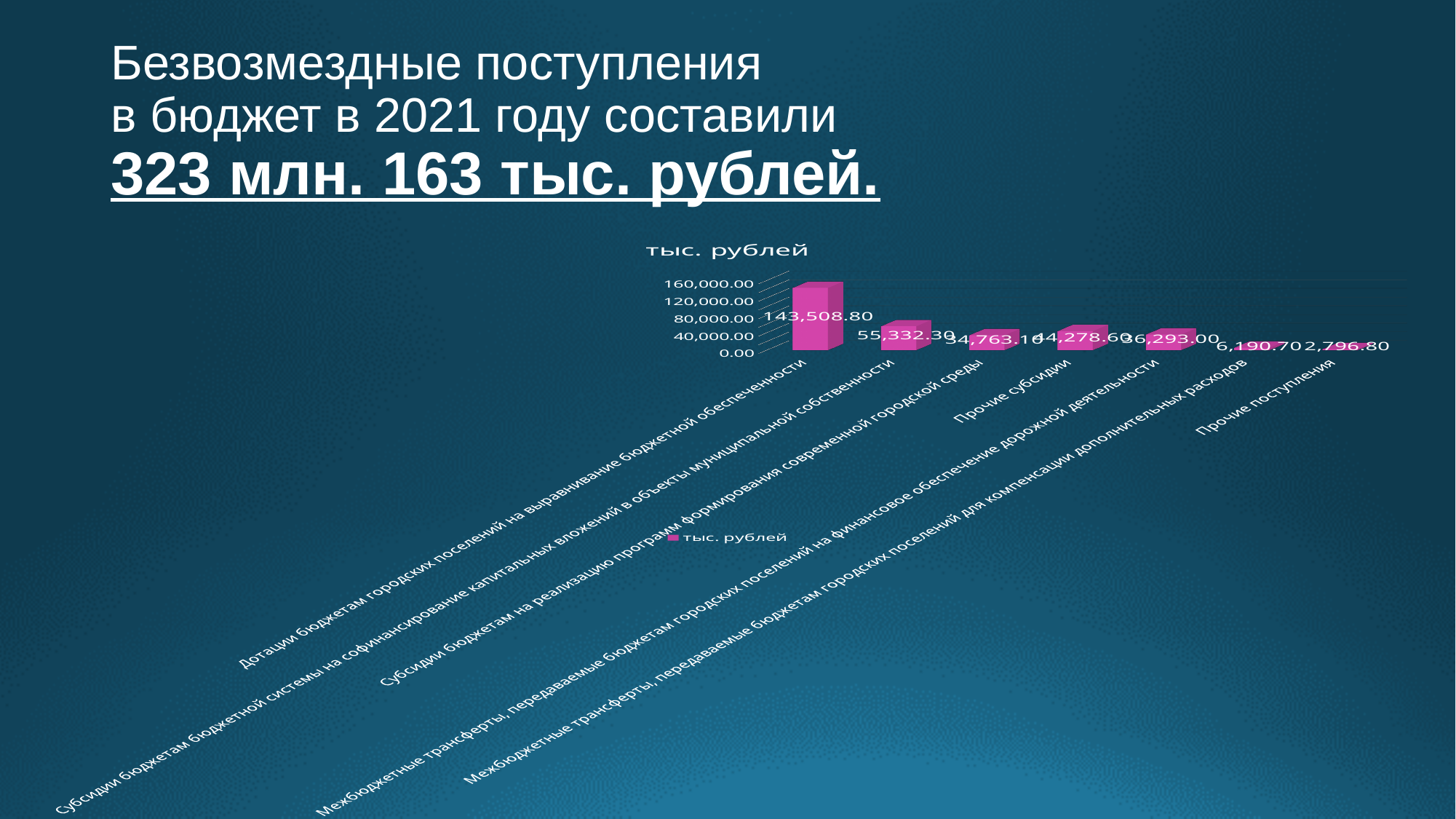
Which category has the highest value in the chart? Дотации бюджетам городских поселений на выравнивание бюджетной обеспеченности Which is larger: the value for Прочие субсидии or the value for Межбюджетные трансферты, передаваемые бюджетам городских поселений на финансовое обеспечение дорожной деятельности? Прочие субсидии How many series does the chart legend list? 1 What is the value for Прочие субсидии? 44,278.60 What is the value for Прочие поступления? 2,796.80 What is the difference between the value for Дотации бюджетам городских поселений на выравнивание бюджетной обеспеченности and the value for Субсидии бюджетам бюджетной системы на софинансирование капитальных вложений в объекты муниципальной собственности? 88,176.50 Which category has the lowest value in the chart? Прочие поступления What is the title of the chart? тыс. рублей What kind of chart is shown on the slide? bar chart How many categories are plotted in the chart? 7 What is the value for Межбюджетные трансферты, передаваемые бюджетам городских поселений для компенсации дополнительных расходов? 6,190.70 What is the value for Дотации бюджетам городских поселений на выравнивание бюджетной обеспеченности? 143,508.80